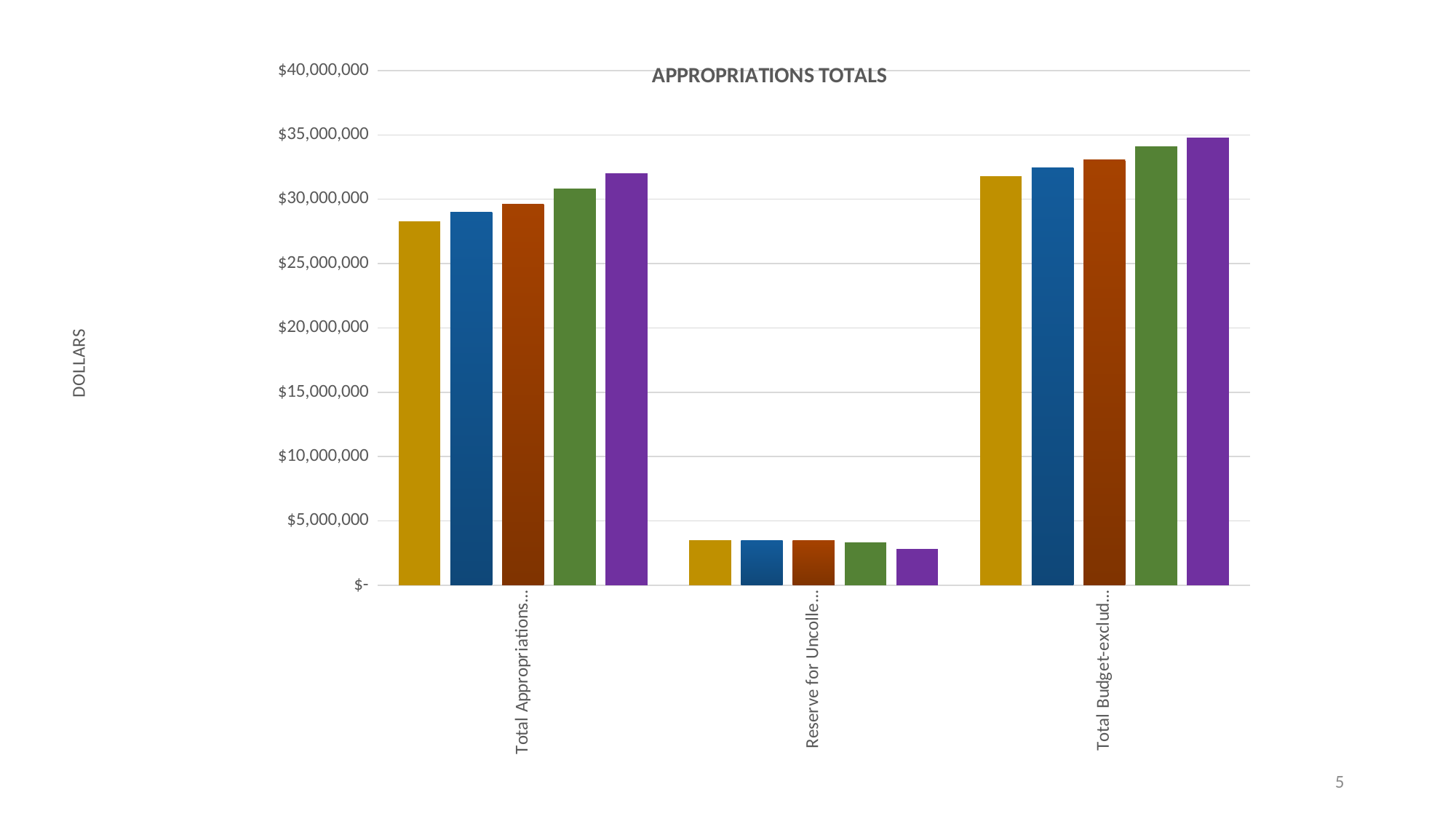
Is the value of the gold (first) bar for Reserve for Uncolle... greater or less than $5,000,000? less What is the title of the chart? APPROPRIATIONS TOTALS What kind of chart is shown on the slide? Bar chart Is the value of the gold (first) bar for Total Appropriations... greater or less than $30,000,000? less How many categories are shown along the x axis of the chart? 3 Which is larger: the purple bar for Total Appropriations... or the purple bar for Total Budget-exclud...? Total Budget-exclud... Which category has the lowest bars in the chart? Reserve for Uncolle... Is the value of the green bar for Total Budget-exclud... greater or less than $35,000,000? less How many bars are plotted for each category in the chart? 5 Which category has the highest bars in the chart? Total Budget-exclud... What is the label on the vertical axis of the chart? DOLLARS